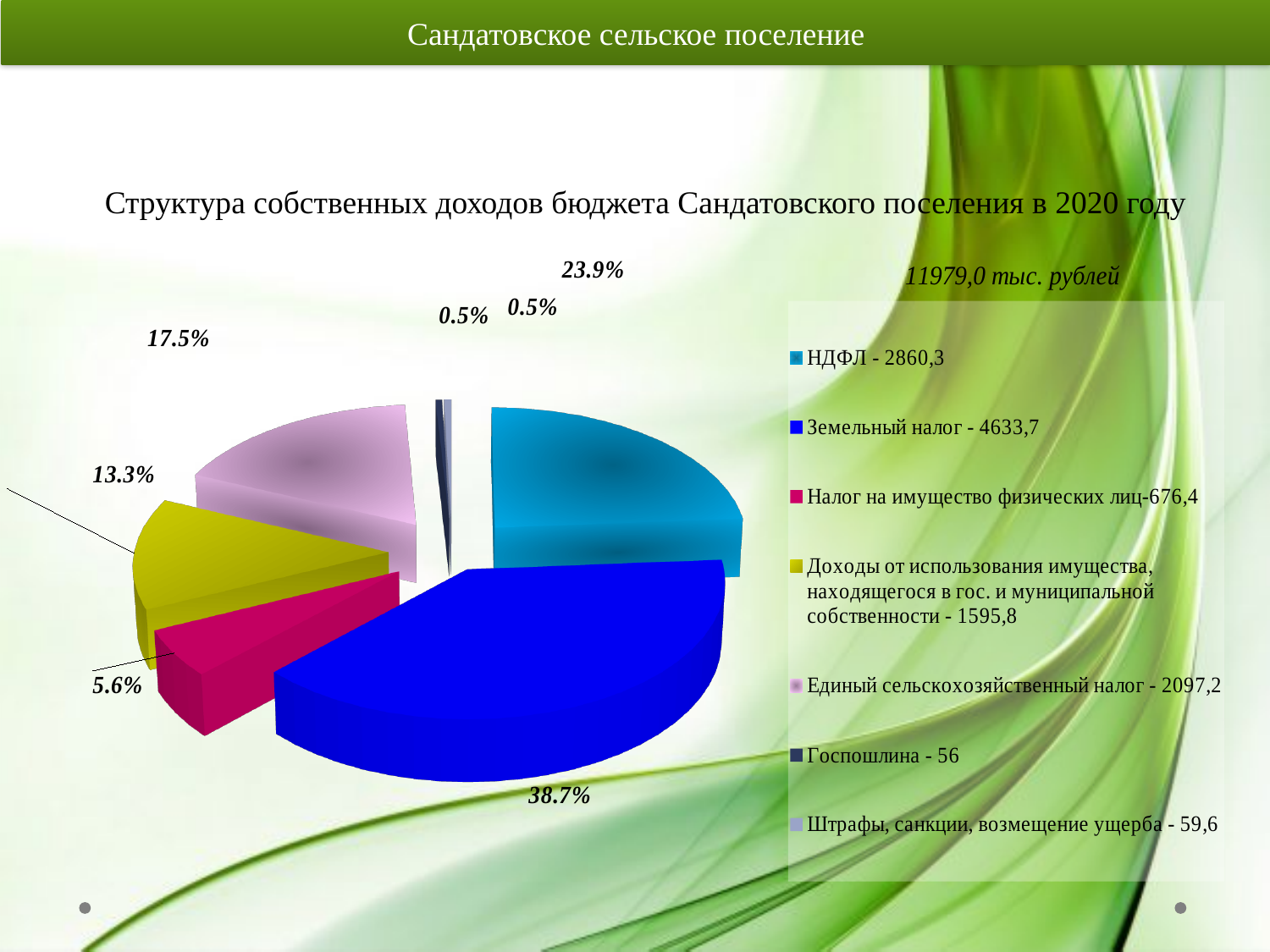
Which category has the smallest value in the legend? Госпошлина - 56 What is the title of the chart? Структура собственных доходов бюджета Сандатовского поселения в 2020 году What share of the pie does Земельный налог represent? 38.7% Which category has the largest share of the pie? Земельный налог What kind of chart is shown on the slide? Pie chart Which is larger: the value for Единый сельскохозяйственный налог or for Доходы от использования имущества? Единый сельскохозяйственный налог What is the difference between the legend values for Земельный налог and НДФЛ? 1773,4 How many categories does the pie chart legend list? 7 What is the value shown in the legend for Земельный налог? 4633,7 What is the value shown in the legend for Единый сельскохозяйственный налог? 2097,2 What total amount is shown above the legend for the pie chart? 11979,0 тыс. рублей What share of the pie does НДФЛ represent? 23.9%